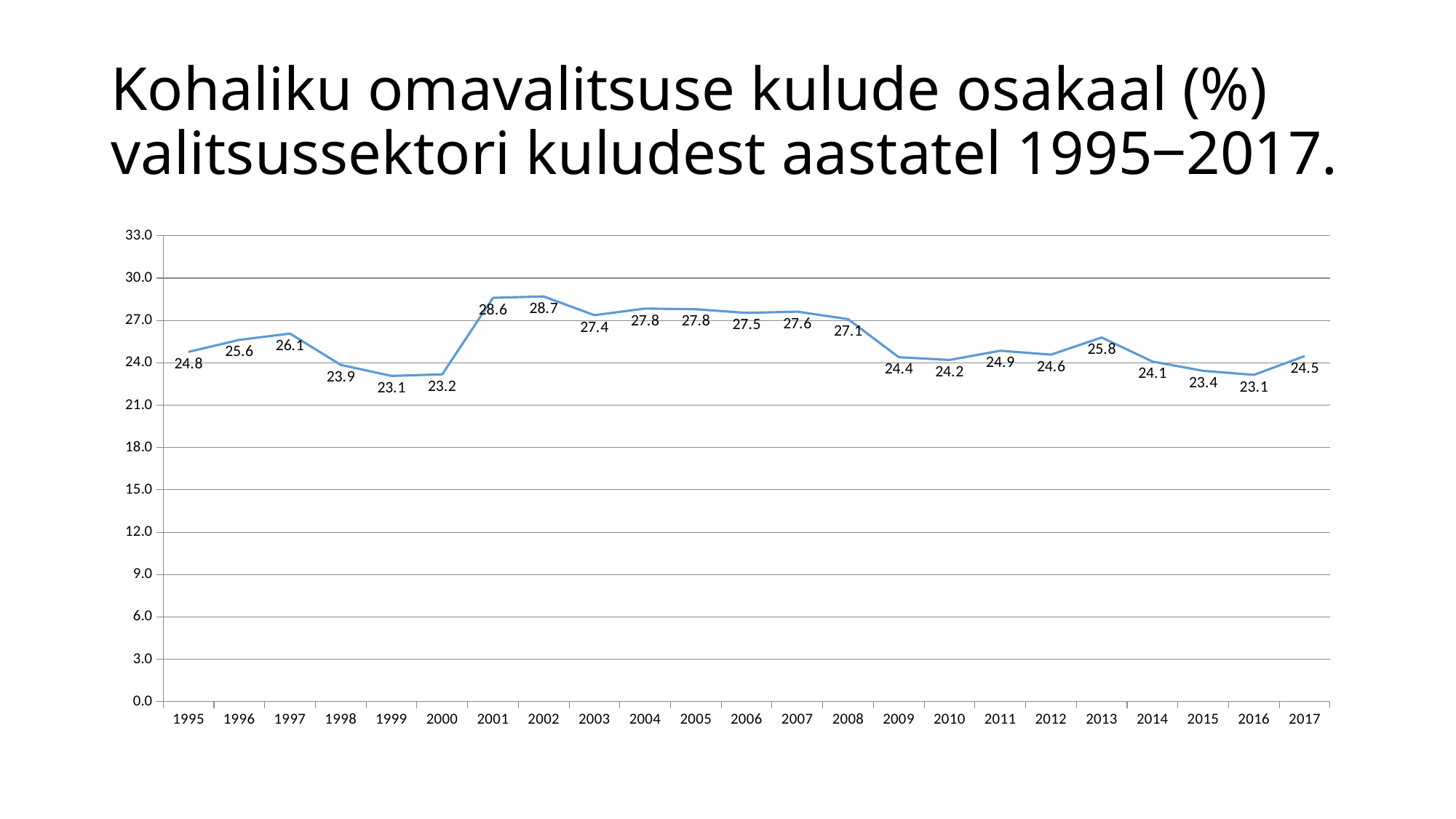
Do the values rise or fall from 2013 to 2016? fall What is the value for 1995? 24.8 What is the value for 2002? 28.7 What kind of chart is shown on the slide? line chart How many years are plotted on the chart? 23 What is the difference between the values for 2001 and 2000? 5.4 Which is larger, the value for 1997 or the value for 2011? 1997 What is the value for 2013? 25.8 What is the value for 2017? 24.5 Which year has the highest value? 2002 Is the value for 2005 greater or less than 27.0? greater What is the lowest value shown on the chart? 23.1